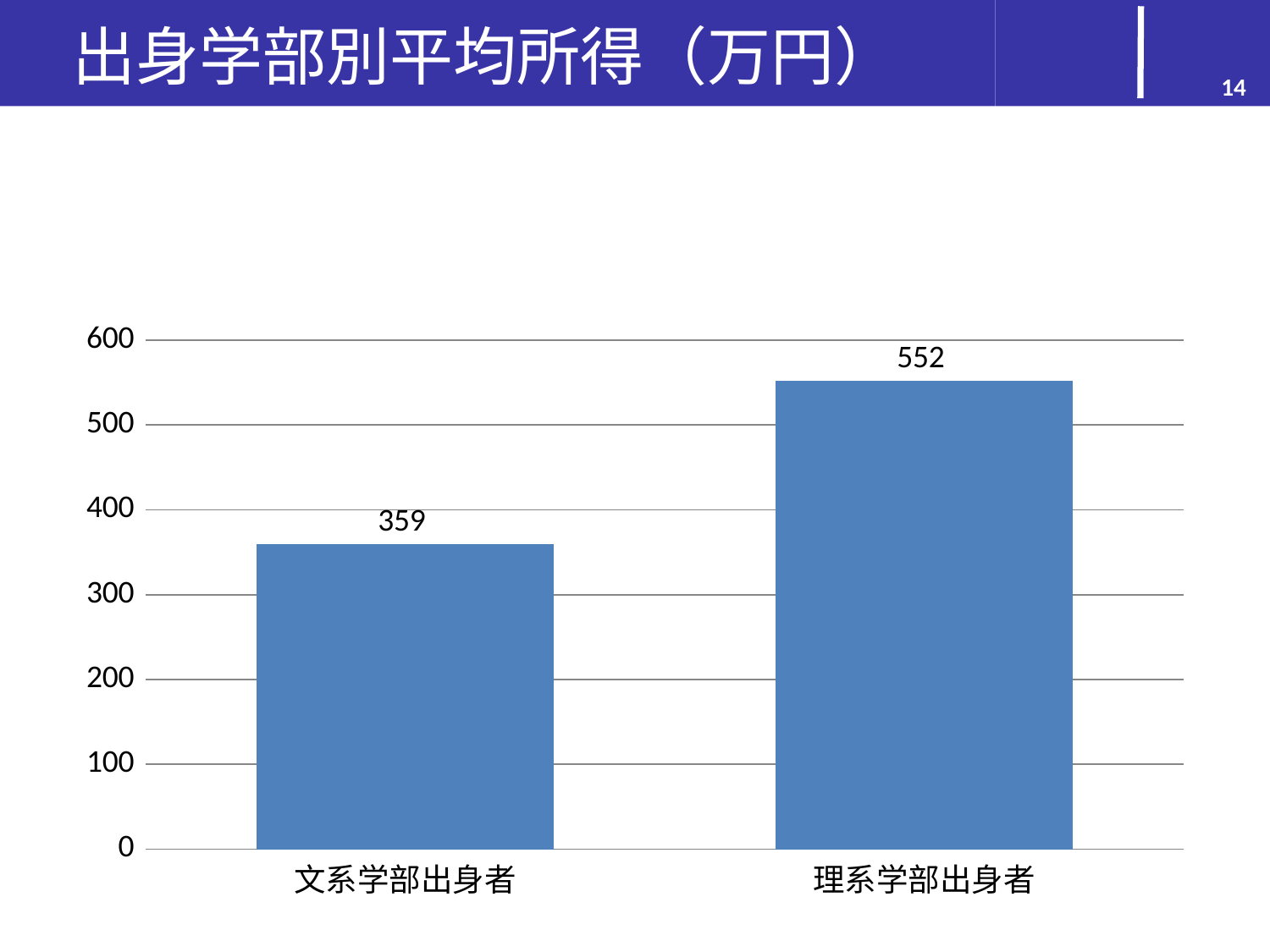
What is the difference between the values for 理系学部出身者 and 文系学部出身者? 193 What is the title of the slide? 出身学部別平均所得（万円） What is the value for 理系学部出身者? 552 Is the value for 理系学部出身者 greater or less than 500? greater Is the value for 文系学部出身者 greater or less than 400? less Which is larger, the value for 文系学部出身者 or the value for 理系学部出身者? 理系学部出身者 What is the highest value shown on the vertical axis? 600 Which category has the lowest value? 文系学部出身者 Which category has the highest value? 理系学部出身者 What kind of chart is shown on the slide? bar chart What is the value for 文系学部出身者? 359 How many categories are shown in the chart? 2